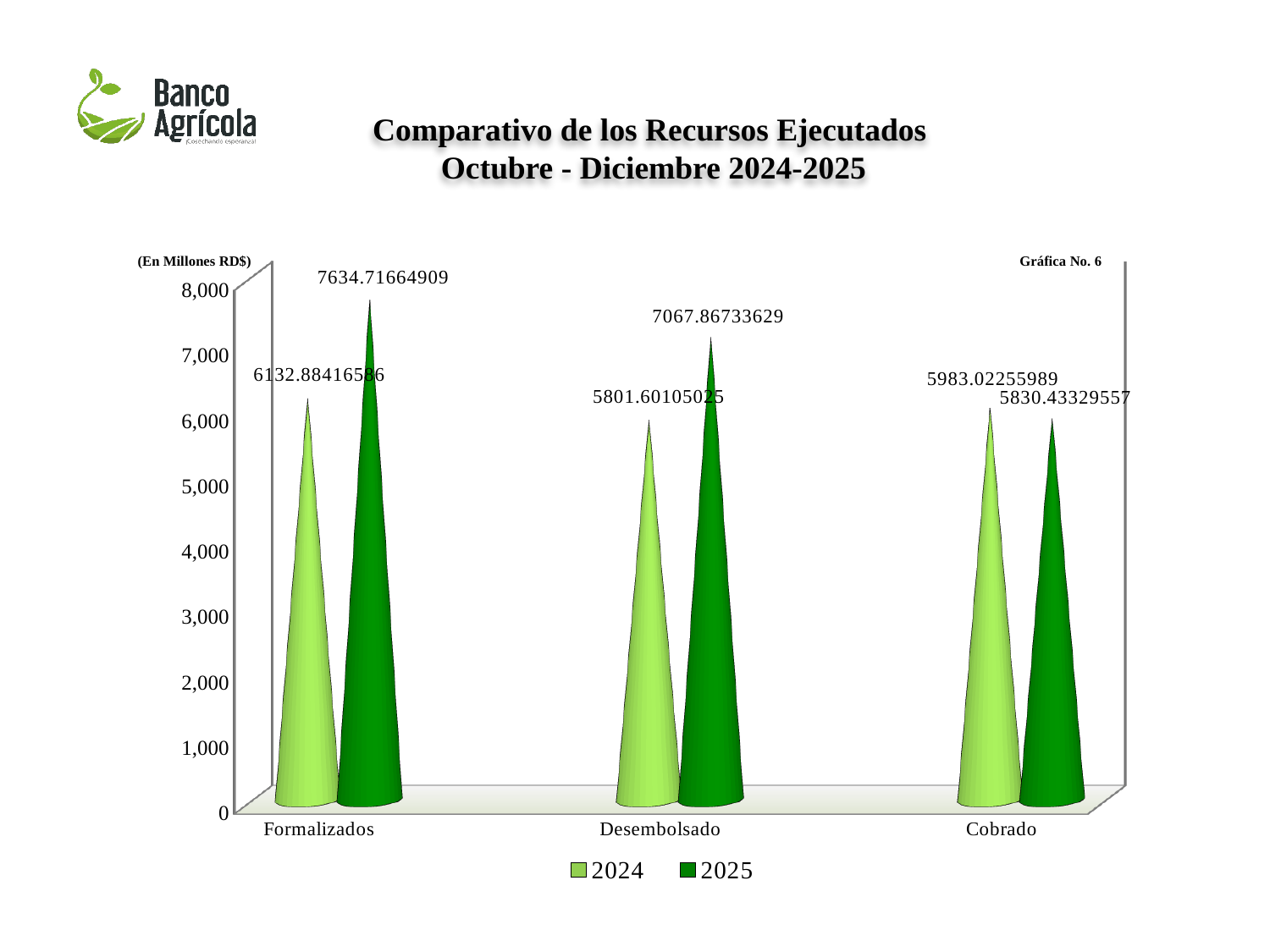
Which category has the lowest value for the 2024 series? Desembolsado Which category has the highest value for the 2025 series? Formalizados How many series does the legend list? 2 How many categories are shown on the x axis? 3 In the Cobrado category, which series has the larger value, 2024 or 2025? 2024 What is the value for 2024 in the Cobrado category? 5983.02255989 Is the 2024 value for Formalizados greater or less than 6,000? greater Do the 2025 values rise or fall from Formalizados to Cobrado? fall What is the value for 2025 in the Cobrado category? 5830.43329557 What is the difference between the 2024 and 2025 values in the Cobrado category? 152.58926432 What is the value for 2025 in the Formalizados category? 7634.71664909 What is the value for 2025 in the Desembolsado category? 7067.86733629